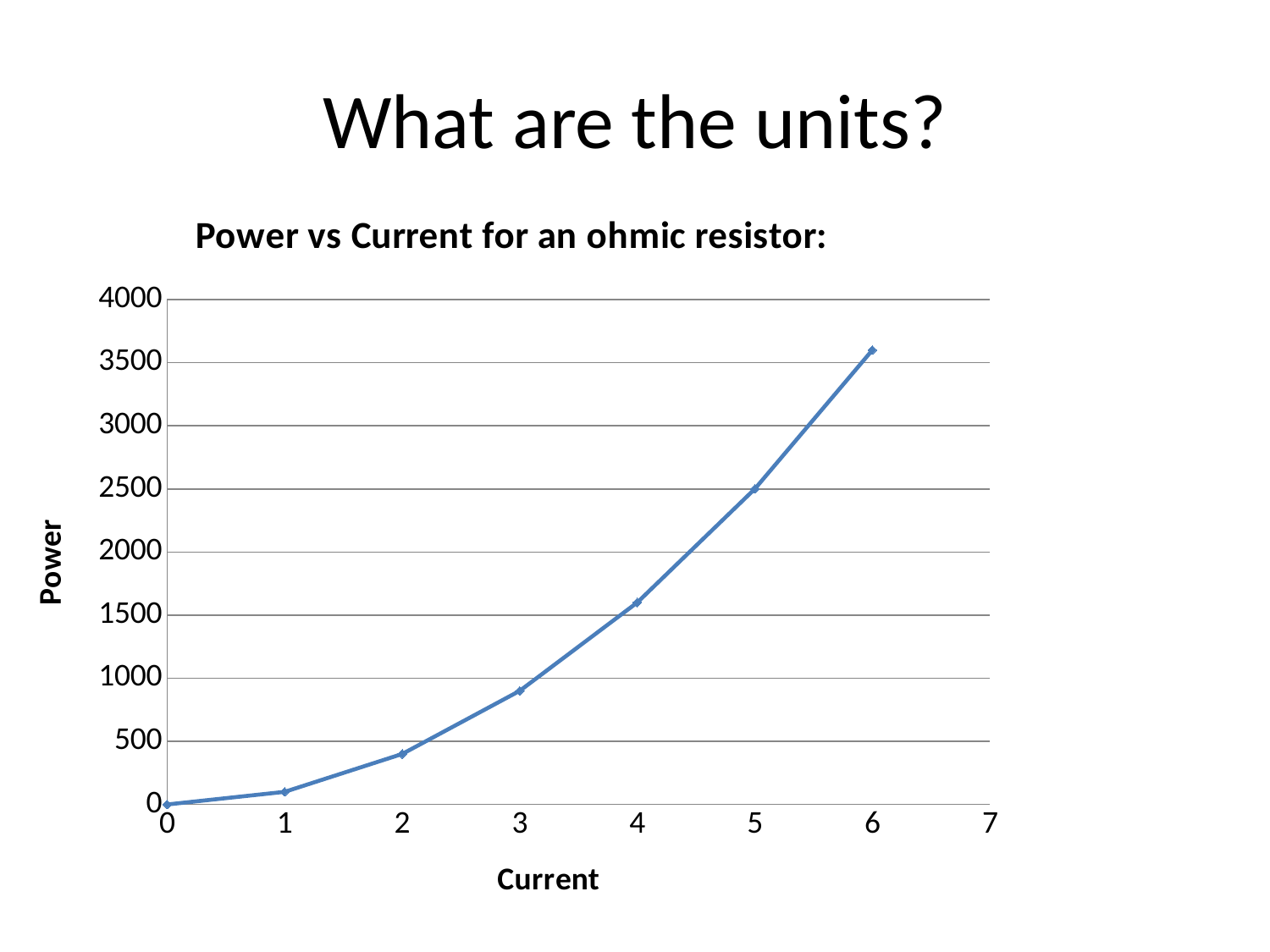
Which has the larger power value, a current of 4 or a current of 2? 4 Is the power value at a current of 3 greater or less than 1000? less Is the power value at a current of 6 greater or less than 3500? greater Does the power rise or fall as current increases along the x axis? rises What is the power value at a current of 0? 0 What is the power value at a current of 5? 2500 How many data points are plotted on the chart? 7 What type of chart is shown on the slide? line chart What is the label of the vertical axis? Power At which current value is the power lowest? 0 What is the title of the chart? Power vs Current for an ohmic resistor: At which current value is the power highest? 6